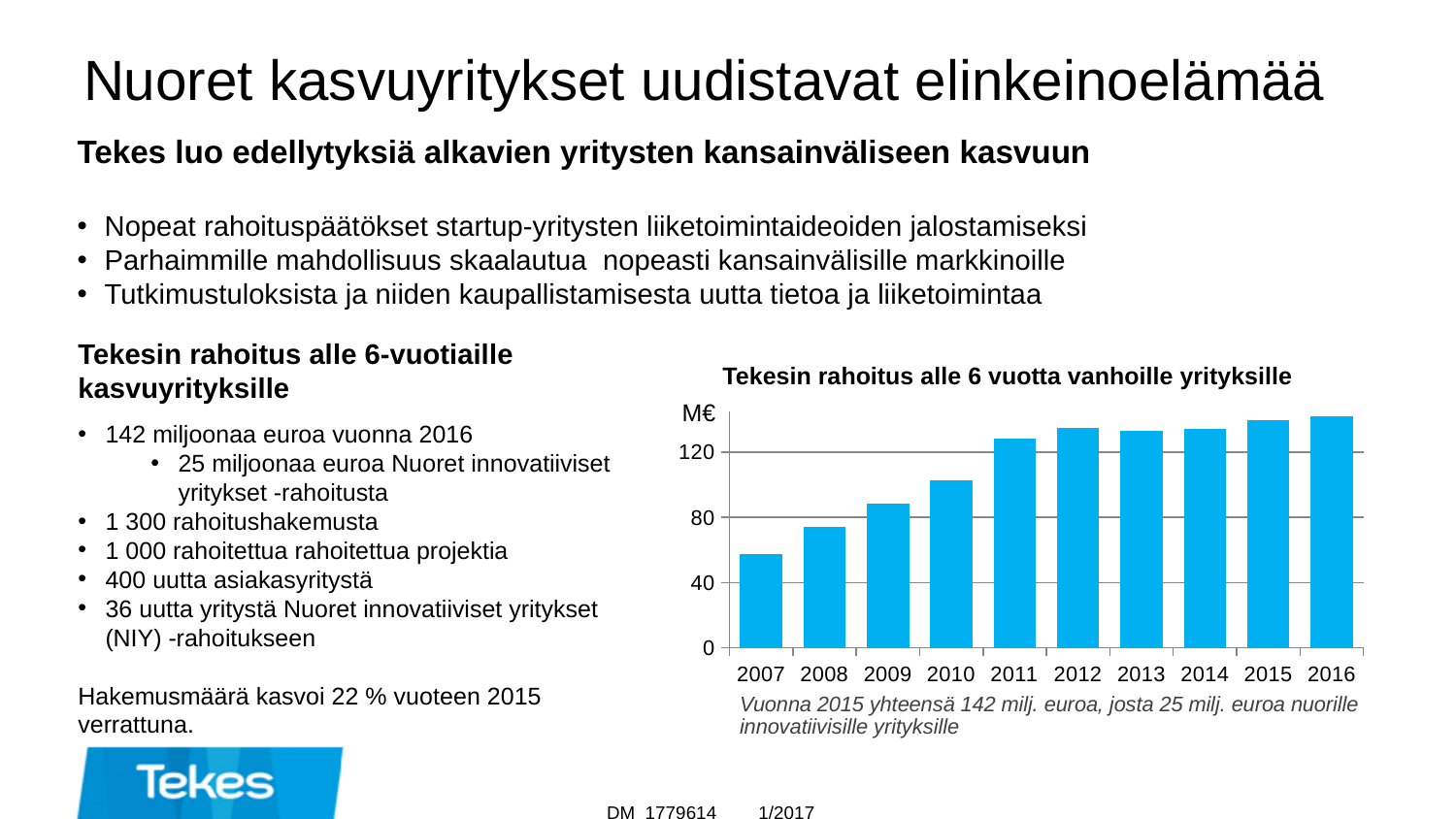
Is the value for 2009 greater or less than 80? greater Do the values generally rise or fall from 2007 to 2016? rise Is the value for 2008 greater or less than 80? less Which year has the lowest value in the chart? 2007 Is the value for 2007 greater or less than 80? less Which is larger, the value for 2009 or the value for 2012? 2012 What is the title of the chart? Tekesin rahoitus alle 6 vuotta vanhoille yrityksille What kind of chart is shown on the slide? bar chart How many years are shown on the x axis of the chart? 10 Which is larger, the value for 2007 or the value for 2010? 2010